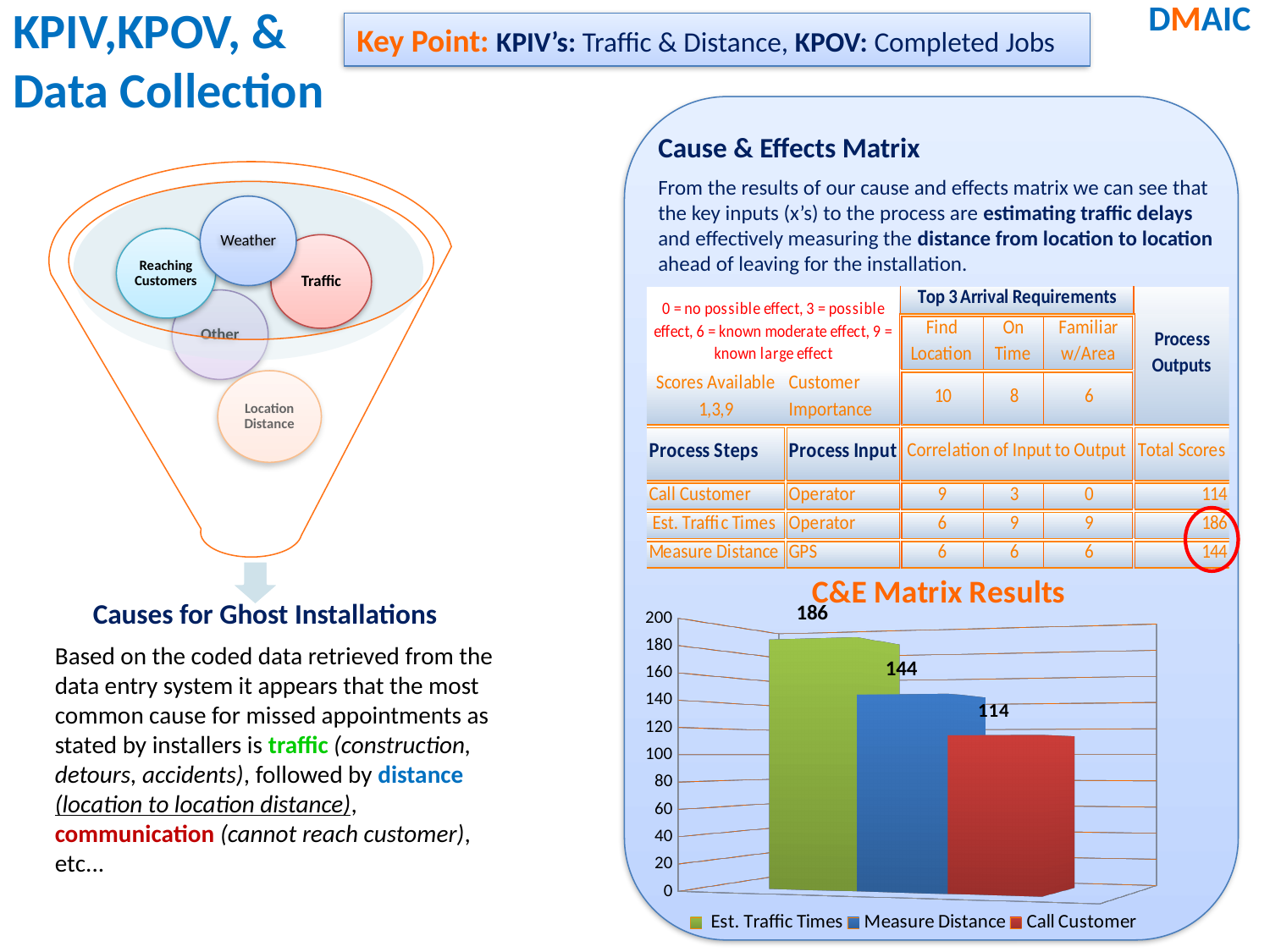
In the C&E Matrix Results chart, what is the difference between Est. Traffic Times and Measure Distance? 42 In the C&E Matrix Results chart, which is larger, Measure Distance or Call Customer? Measure Distance What is the title of the chart at the bottom right of the slide? C&E Matrix Results In the C&E Matrix Results chart, what is the value for Call Customer? 114 In the C&E Matrix Results chart, what is the value for Est. Traffic Times? 186 In the C&E Matrix Results chart, which category has the lowest value? Call Customer In the C&E Matrix Results chart, is the value for Call Customer greater or less than 120? less In the C&E Matrix Results chart, what is the difference between Measure Distance and Call Customer? 30 What kind of chart is the C&E Matrix Results chart? bar chart In the C&E Matrix Results chart, which category has the highest value? Est. Traffic Times In the C&E Matrix Results chart, what is the value for Measure Distance? 144 How many entries does the legend of the C&E Matrix Results chart list? 3